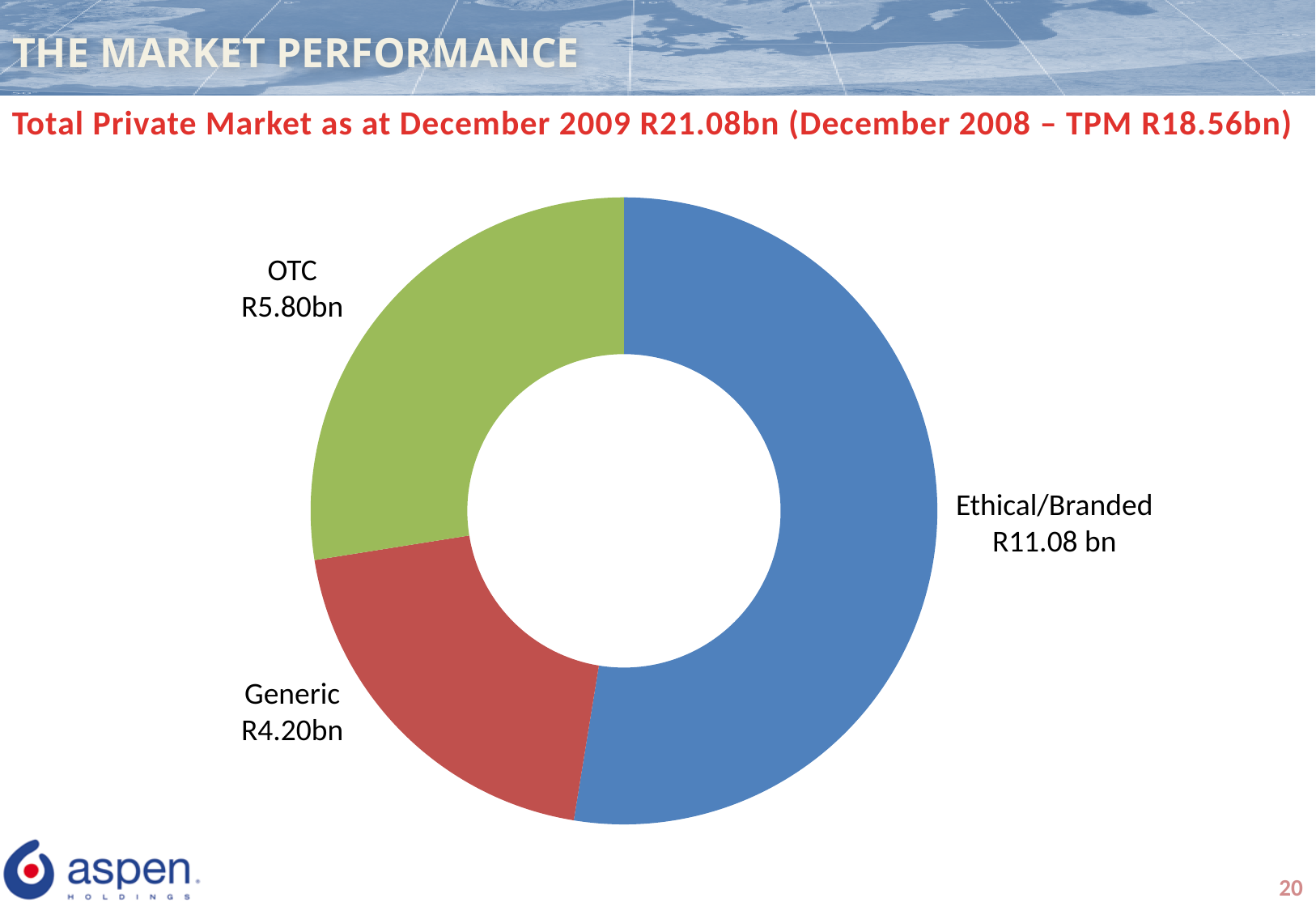
Which is larger, the OTC segment or the Generic segment? OTC How many segments does the chart have? 3 Which segment has the smallest value? Generic What colour is the Generic segment? red Which segment has the largest value? Ethical/Branded What is the value of the Ethical/Branded segment? R11.08 bn What is the value of the Generic segment? R4.20bn What is the value of the OTC segment? R5.80bn What kind of chart is shown on the slide? doughnut chart What is the difference between the Ethical/Branded and OTC values? R5.28bn What is the total of the three segments shown in the chart? R21.08bn What is the difference between the OTC and Generic values? R1.60bn